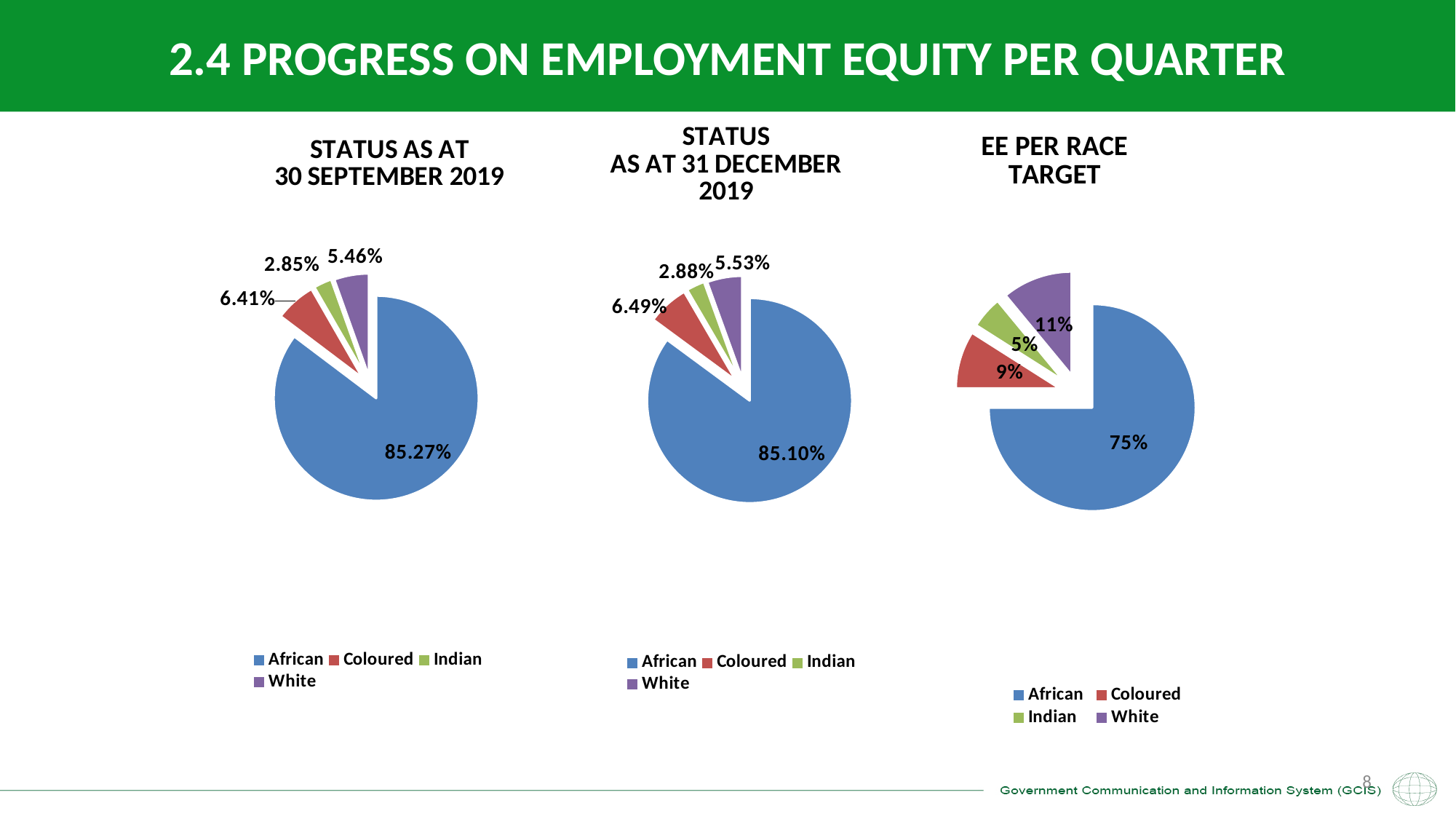
In the 'STATUS AS AT 31 DECEMBER 2019' chart, what is the value for Indian? 2.88% How many categories does the legend of the 'STATUS AS AT 30 SEPTEMBER 2019' chart list? 4 What type of chart is used for 'EE PER RACE TARGET'? Pie chart In the 'EE PER RACE TARGET' chart, what is the difference between the White target and the Indian target? 6% In the 'EE PER RACE TARGET' chart, what is the target for Coloured? 9% In the 'STATUS AS AT 30 SEPTEMBER 2019' chart, what share does the African slice have? 85.27% In the 'STATUS AS AT 31 DECEMBER 2019' chart, which colour represents Indian? Green In the 'STATUS AS AT 31 DECEMBER 2019' chart, which is larger, the Coloured slice or the White slice? Coloured In the 'EE PER RACE TARGET' chart, which category has the smallest slice? Indian In the 'STATUS AS AT 30 SEPTEMBER 2019' chart, which category has the largest slice? African In the 'STATUS AS AT 31 DECEMBER 2019' chart, what is the value for White? 5.53% In the 'STATUS AS AT 30 SEPTEMBER 2019' chart, what is the value for Coloured? 6.41%